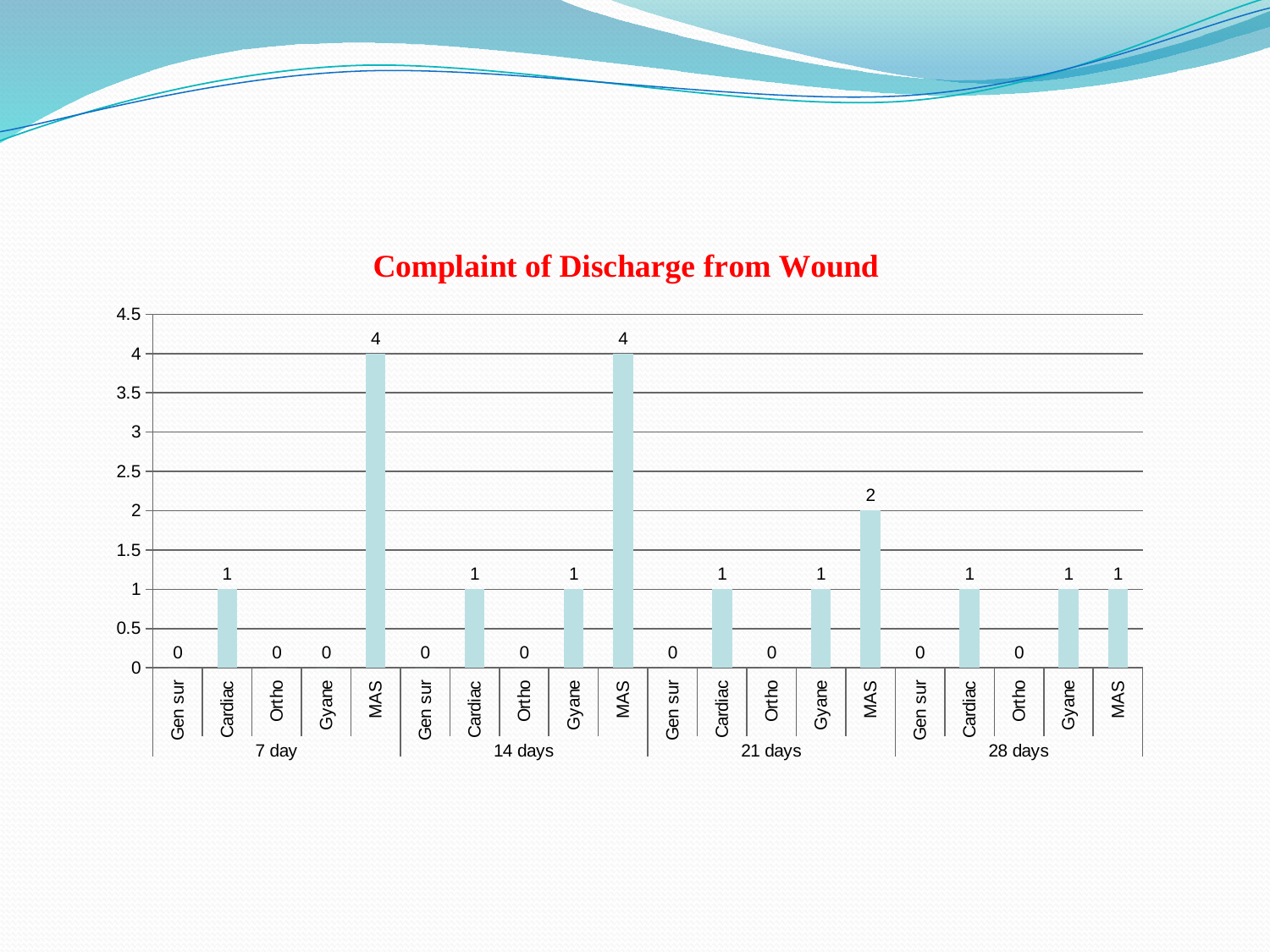
What kind of chart is this? Bar chart Which is larger, the MAS value at 7 day or the MAS value at 21 days? MAS at 7 day What is the value for Ortho at 28 days? 0 What is the title of the chart? Complaint of Discharge from Wound What is the difference between the MAS values at 14 days and 28 days? 3 Which department has the highest value at 21 days? MAS What is the value for MAS at 21 days? 2 What is the value for Gyane at 14 days? 1 Do the MAS values rise or fall from 14 days to 28 days? Fall How many time-period groups are shown on the x axis? 4 What is the value for MAS at 7 day? 4 How many departments are shown within each time-period group? 5